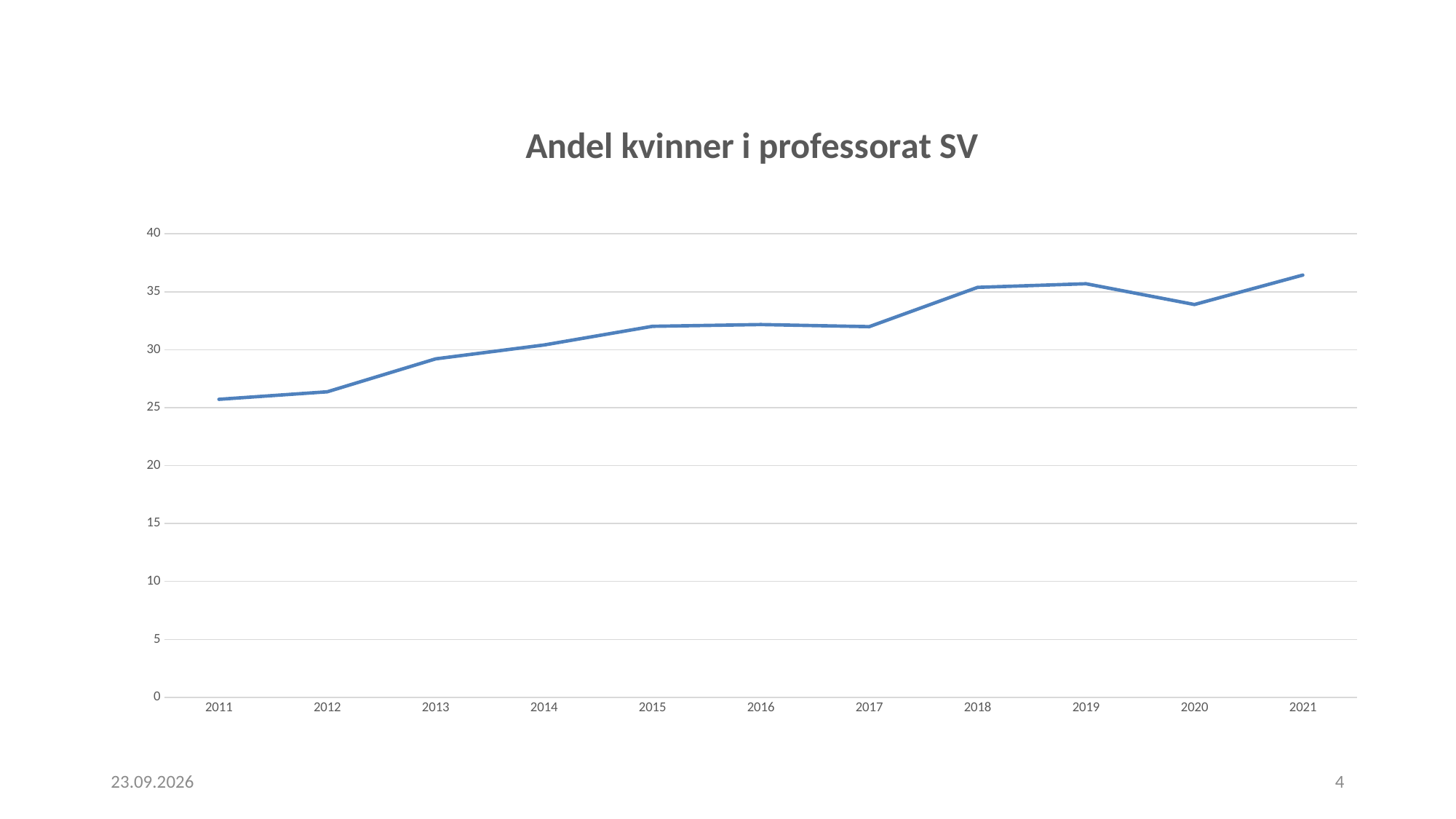
How many years are plotted on the x axis? 11 What kind of chart is shown on the slide? line chart Is the value for 2013 greater or less than 30? less Which year has the highest value? 2021 Is the value for 2021 greater or less than 35? greater Is the value for 2020 greater or less than 35? less What is the title of the chart? Andel kvinner i professorat SV Which year has the lowest value? 2011 Do the values generally rise or fall from 2011 to 2021? rise Which is larger, the value for 2019 or the value for 2020? 2019